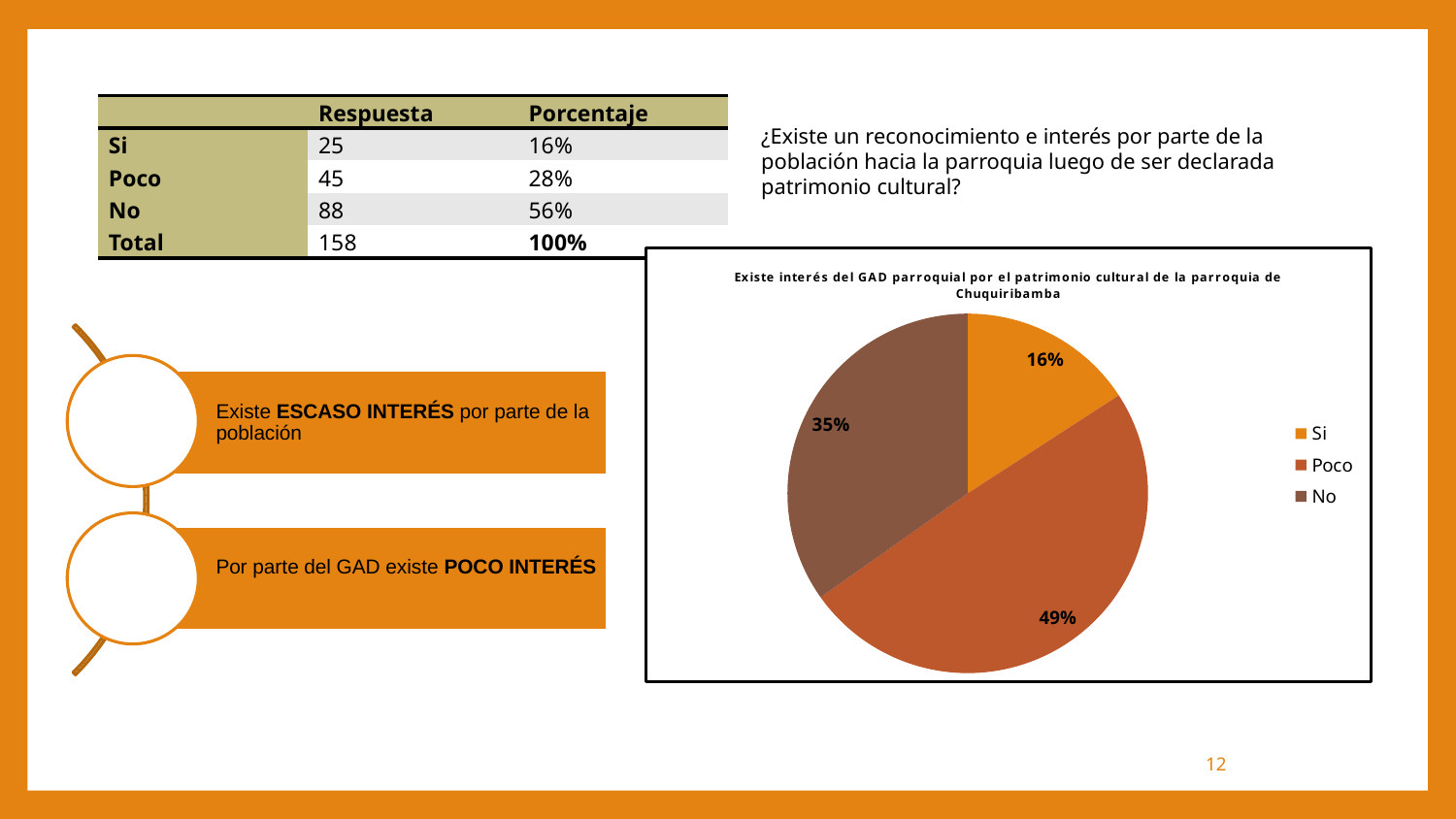
What percentage does the pie chart show for Si? 16% In the pie chart, what is the difference in percentage points between the Poco slice and the No slice? 14 What percentage does the pie chart show for No? 35% What is the title of the pie chart? Existe interés del GAD parroquial por el patrimonio cultural de la parroquia de Chuquiribamba How many slices does the pie chart have? 3 What percentage does the pie chart show for Poco? 49% In the pie chart, which is larger, the slice for No or the slice for Si? No Which legend entry in the pie chart is shown in the lightest orange colour? Si Which category has the largest slice in the pie chart? Poco Which category has the smallest slice in the pie chart? Si How many entries does the pie chart's legend list? 3 What kind of chart is shown on the slide? pie chart